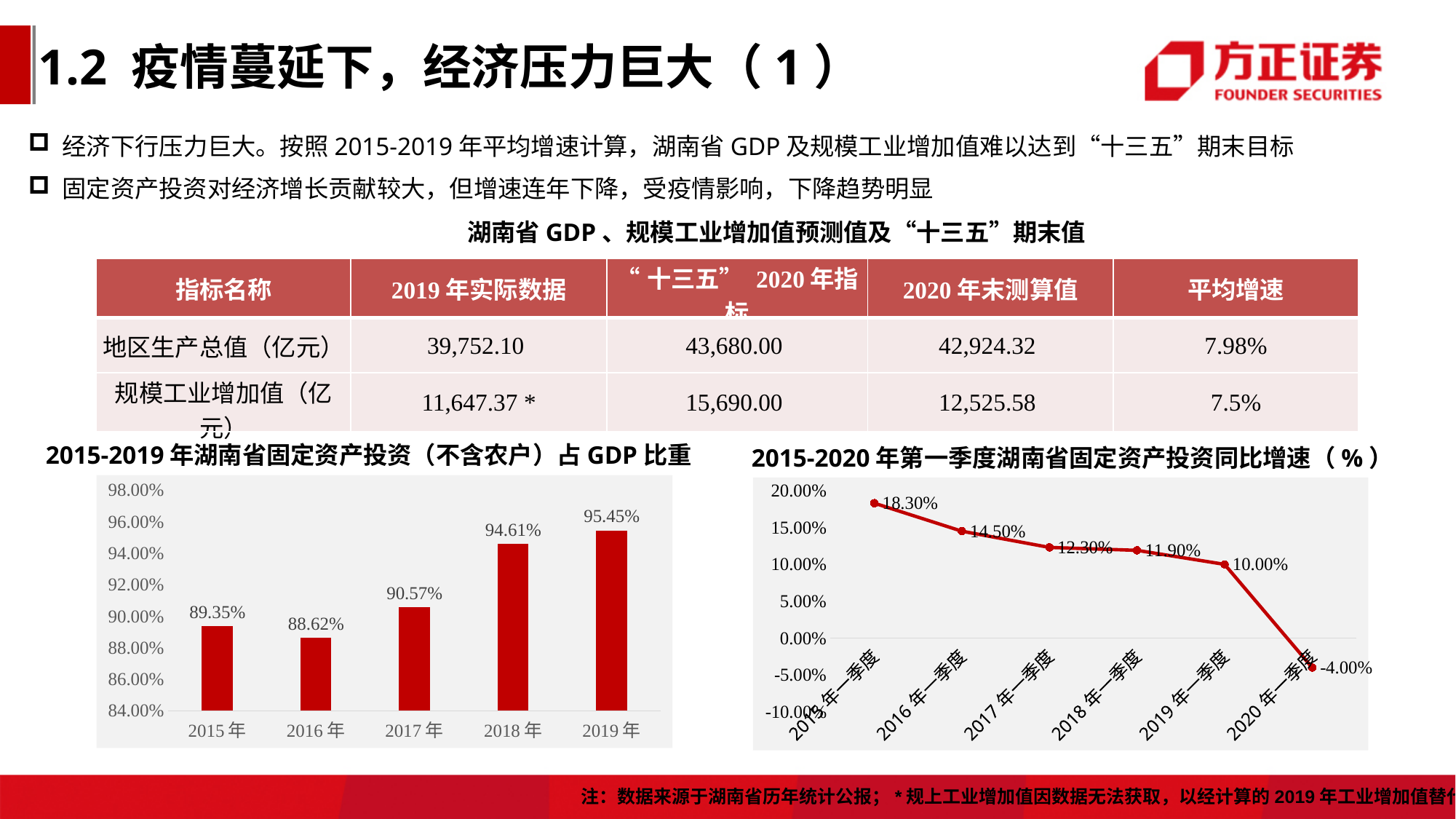
In the left chart (2015-2019年湖南省固定资产投资（不含农户）占GDP比重), which year has the highest value? 2019年 In the left chart (2015-2019年湖南省固定资产投资（不含农户）占GDP比重), what is the value for 2017年? 90.57% In the left chart (2015-2019年湖南省固定资产投资（不含农户）占GDP比重), how many bars are plotted? 5 In the right chart (2015-2020年第一季度湖南省固定资产投资同比增速), do the values rise or fall from 2015年一季度 to 2020年一季度? Fall What type of chart is the right chart (2015-2020年第一季度湖南省固定资产投资同比增速)? Line chart In the left chart (2015-2019年湖南省固定资产投资（不含农户）占GDP比重), which year has the lowest value? 2016年 In the right chart (2015-2020年第一季度湖南省固定资产投资同比增速), what is the value for 2018年一季度? 11.90% In the right chart (2015-2020年第一季度湖南省固定资产投资同比增速), how many data points are plotted? 6 In the right chart (2015-2020年第一季度湖南省固定资产投资同比增速), which quarter has the lowest value? 2020年一季度 In the right chart (2015-2020年第一季度湖南省固定资产投资同比增速), what is the difference between the 2015年一季度 and 2016年一季度 values? 3.80% What type of chart is the left chart (2015-2019年湖南省固定资产投资（不含农户）占GDP比重)? Bar chart In the left chart (2015-2019年湖南省固定资产投资（不含农户）占GDP比重), what is the difference between the 2019年 and 2018年 values? 0.84%